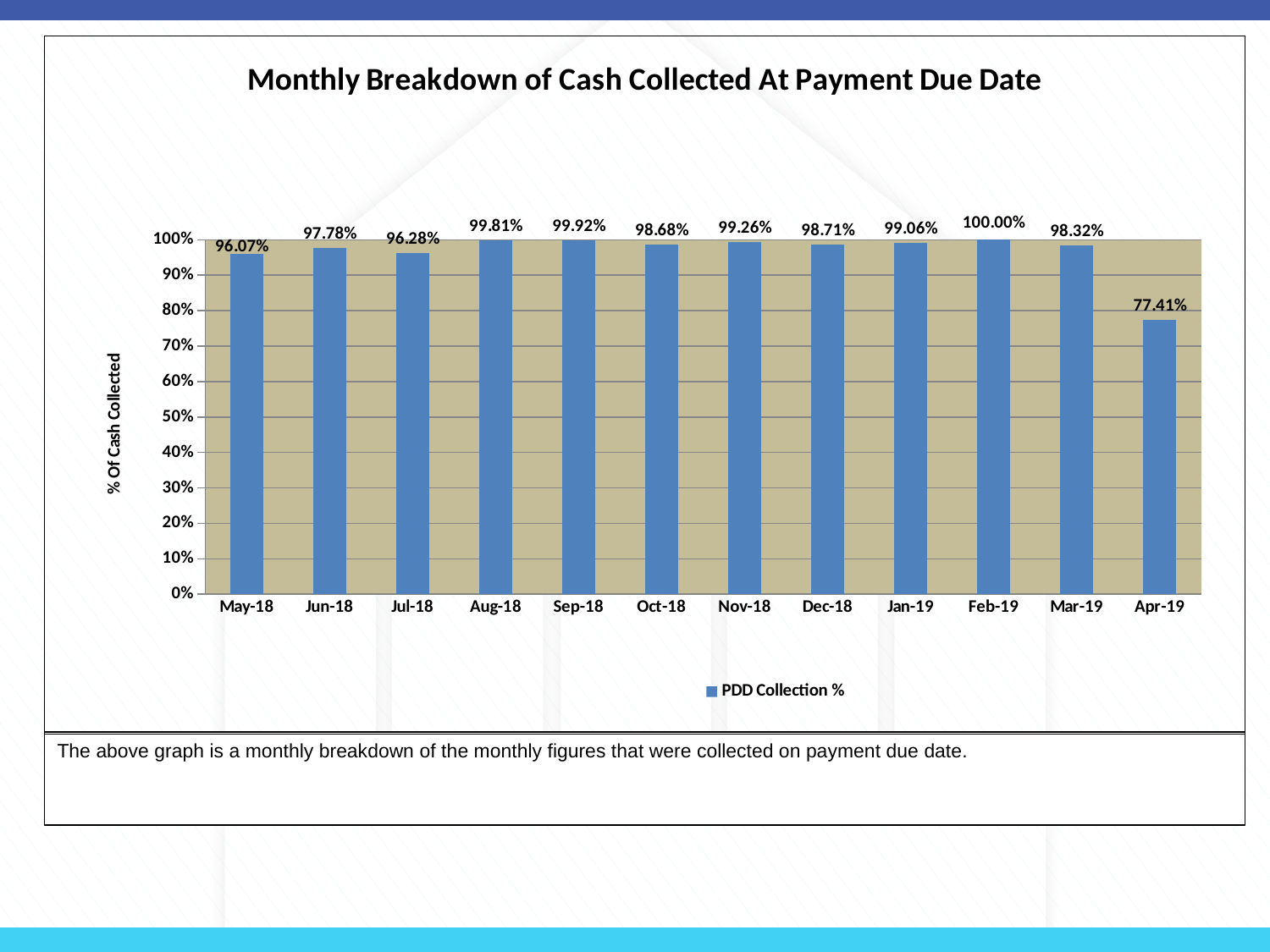
Which month has the lowest PDD Collection %? Apr-19 What is the title of the chart? Monthly Breakdown of Cash Collected At Payment Due Date Which month has a higher PDD Collection %, May-18 or Jun-18? Jun-18 What kind of chart is shown on the slide? Bar chart How many series does the legend list? 1 What is the PDD Collection % for Aug-18? 99.81% What is the PDD Collection % for Apr-19? 77.41% How many months are shown on the x axis? 12 What is the PDD Collection % for Jan-19? 99.06% What is the difference between the PDD Collection % for Feb-19 and Apr-19? 22.59% Which month has the highest PDD Collection %? Feb-19 Is the value for Apr-19 greater or less than 80%? less